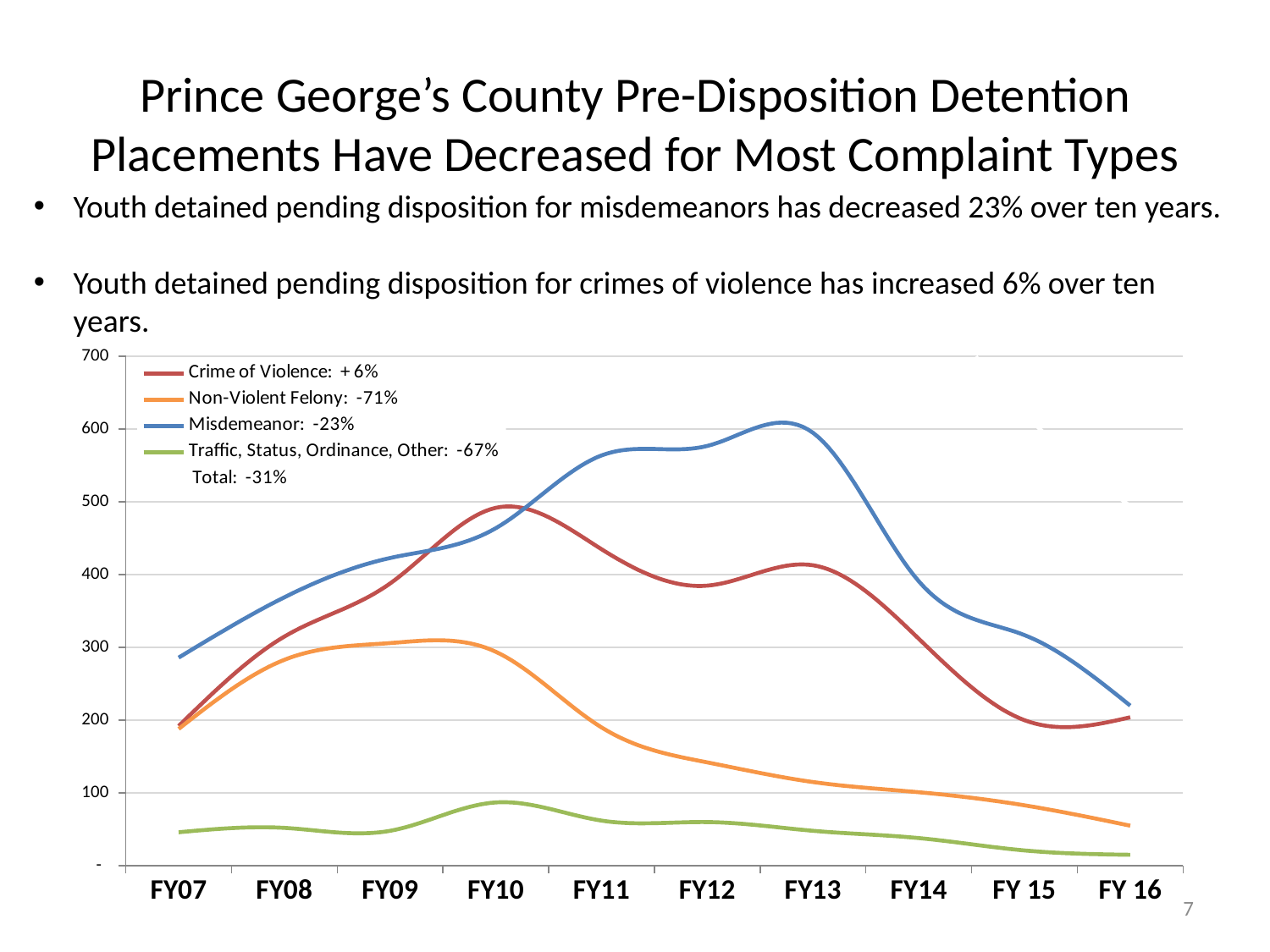
Is the Misdemeanor value for FY07 greater or less than 300? less Is the Misdemeanor value for FY 16 greater or less than 200? greater What kind of chart is shown on the slide? line chart Does the Non-Violent Felony line rise or fall from FY10 to FY 16? fall At FY07, which is larger: the Crime of Violence value or the Misdemeanor value? Misdemeanor Which series has the lowest values across all fiscal years? Traffic, Status, Ordinance, Other Is the Misdemeanor value for FY12 greater or less than 500? greater Which series has the highest value at FY13? Misdemeanor How many fiscal years are shown along the x axis? 10 How many series does the chart's legend list with a line marker? 4 What percentage change does the legend give for Misdemeanor? -23%